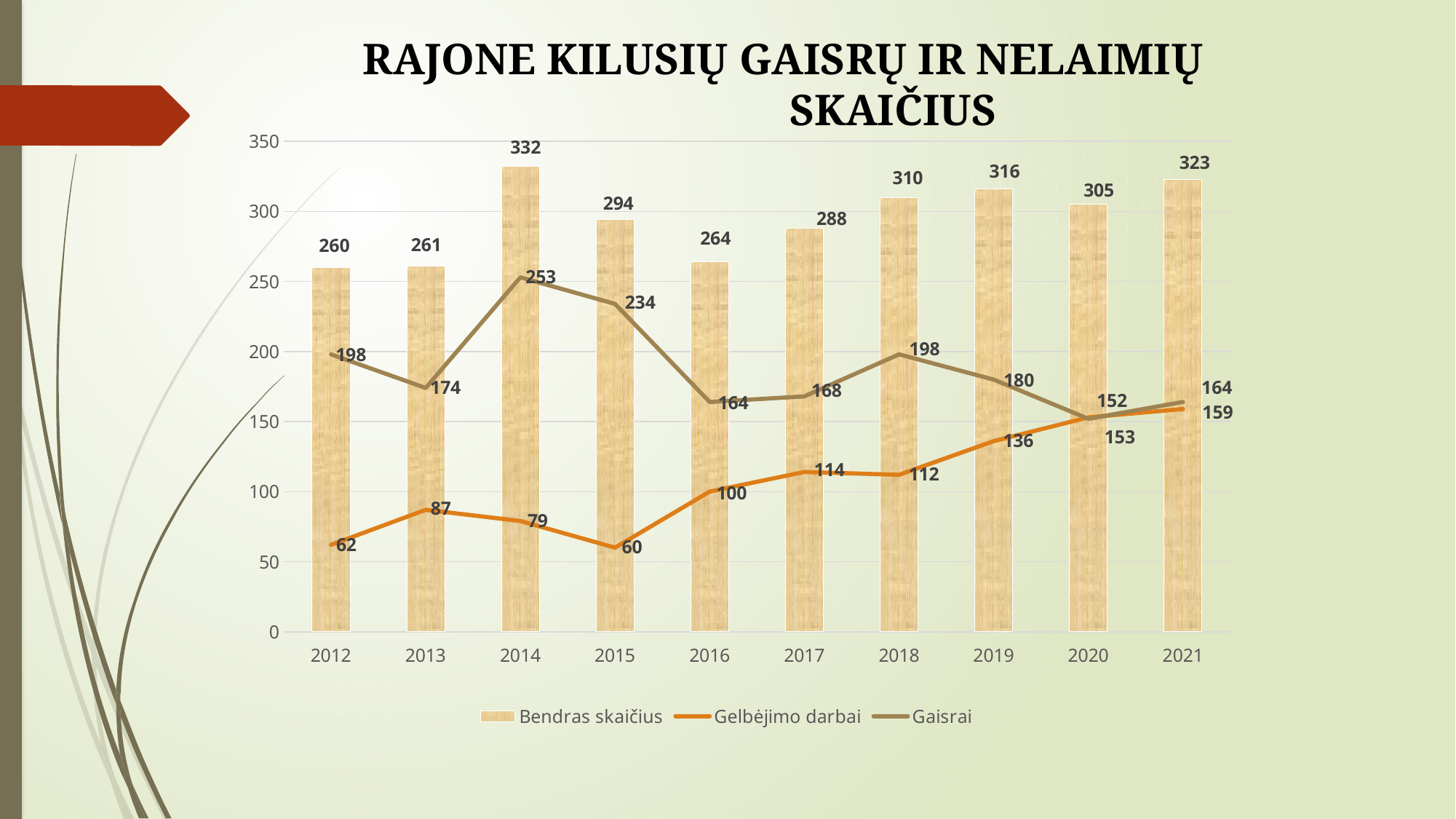
What is the value of Gaisrai for 2015? 234 What is the value of Bendras skaičius for 2014? 332 Does Gelbėjimo darbai rise or fall from 2015 to 2021? Rise What is the title of the chart? RAJONE KILUSIŲ GAISRŲ IR NELAIMIŲ SKAIČIUS What is the value of Gelbėjimo darbai for 2016? 100 What kind of chart is this? Combined bar and line chart How many years are shown on the x axis? 10 What is the difference between Bendras skaičius in 2021 and in 2012? 63 How many series does the legend list? 3 Which is larger in 2018: Gaisrai or Gelbėjimo darbai? Gaisrai In which year is Bendras skaičius highest? 2014 In which year is Gelbėjimo darbai lowest? 2015